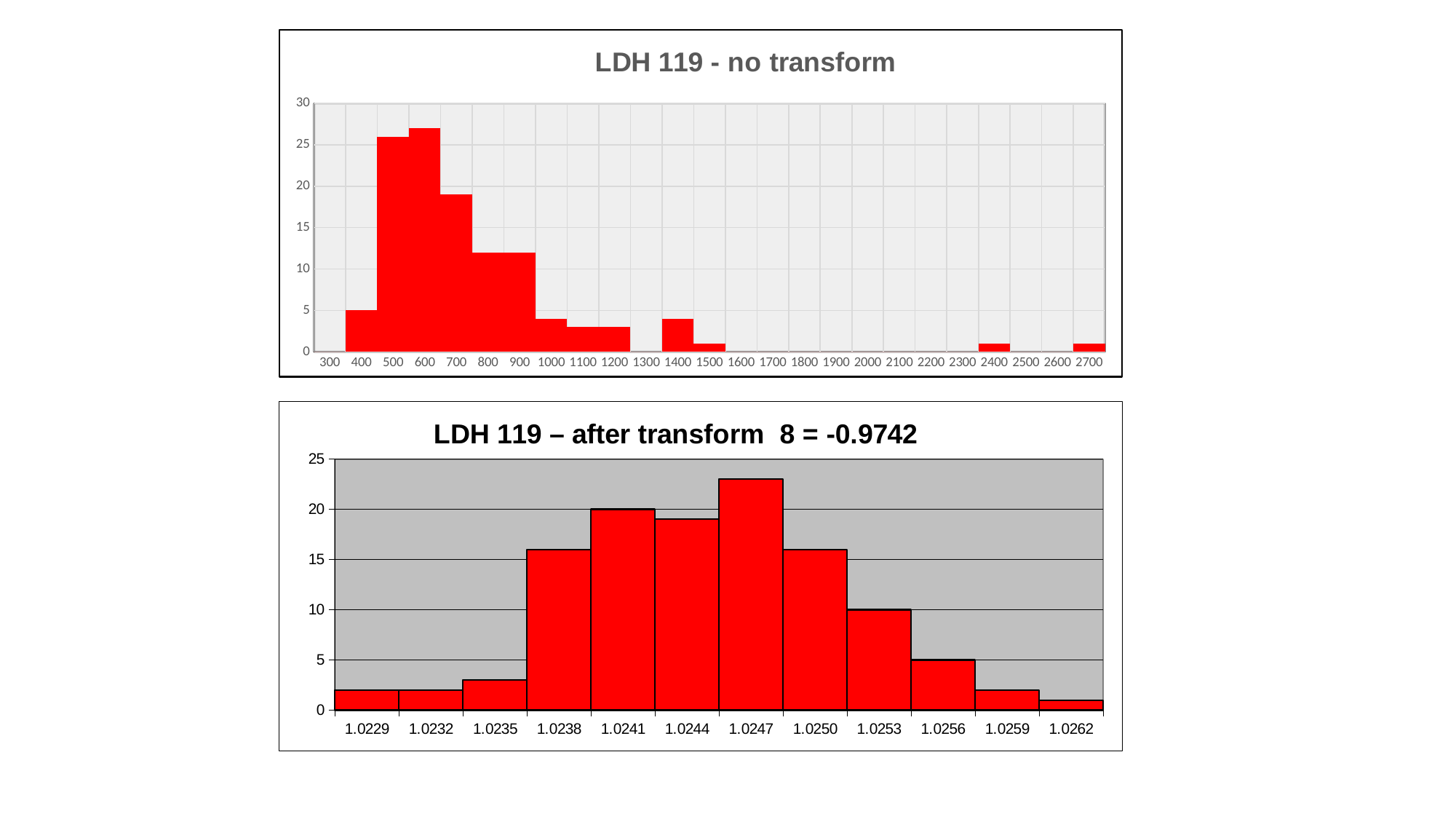
In the chart titled "LDH 119 - no transform", which x-axis bin has the tallest bar? 600 What type of chart is the top chart on the slide? bar chart In the chart titled "LDH 119 – after transform", what is the value of the bar at 1.0241? 20 In the chart titled "LDH 119 - no transform", which bar is taller, the one at 500 or the one at 800? 500 In the chart titled "LDH 119 – after transform", is the value of the bar at 1.0238 greater or less than 15? greater In the chart titled "LDH 119 – after transform", what is the value of the bar at 1.0253? 10 In the chart titled "LDH 119 – after transform", which x-axis bin has the tallest bar? 1.0247 In the chart titled "LDH 119 - no transform", is the value of the bar at 700 greater or less than 20? less In the chart titled "LDH 119 – after transform", what is the value of the bar at 1.0256? 5 In the chart titled "LDH 119 - no transform", is the value of the bar at 500 greater or less than 25? greater In the chart titled "LDH 119 - no transform", what is the value of the bar at 400? 5 In the chart titled "LDH 119 – after transform", how many bars are plotted? 12